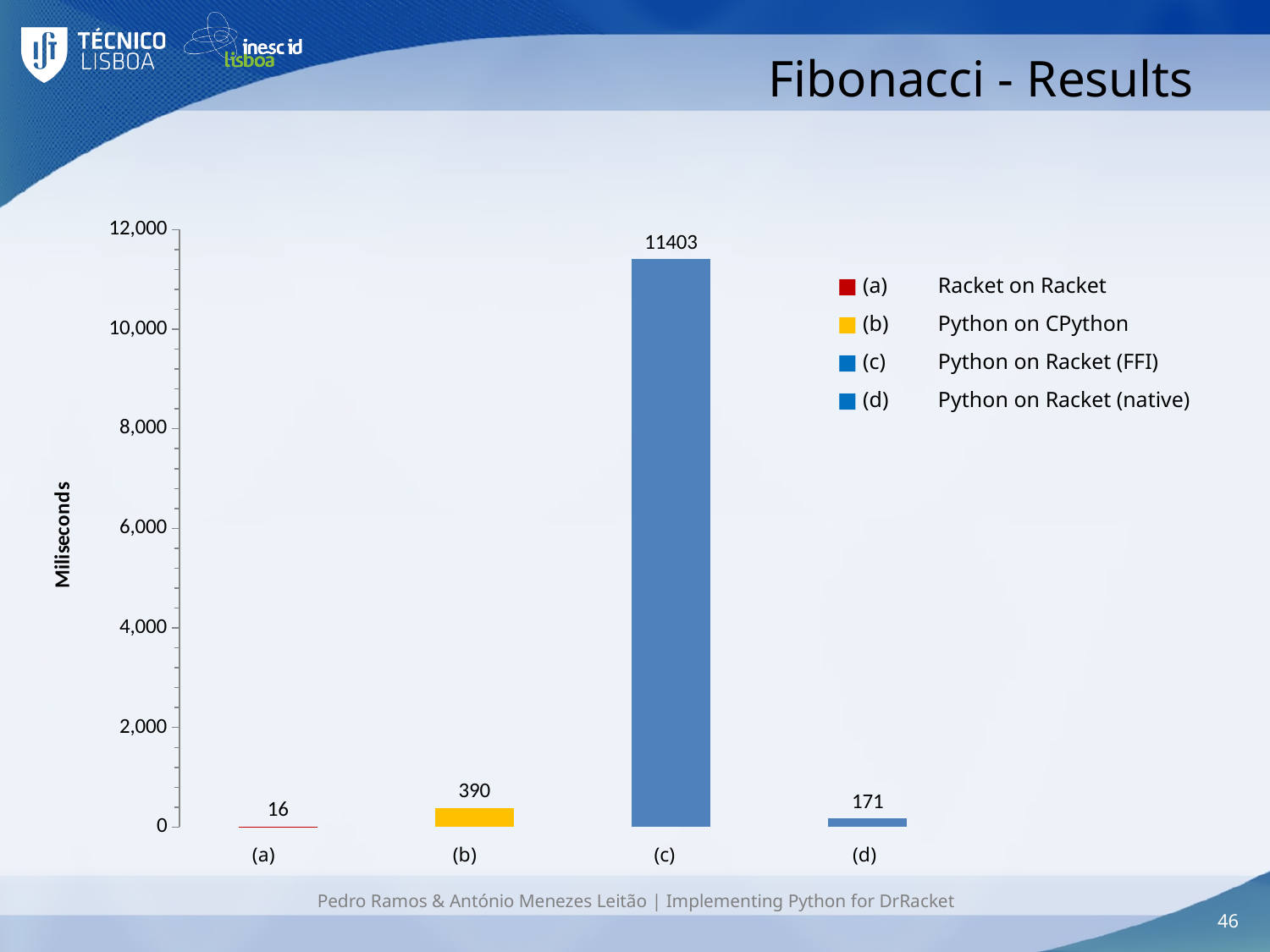
Which is larger, the value for (b) or the value for (d)? (b) What is the difference between the values for (b) and (d)? 219 What is the value for (d) in the Fibonacci results chart? 171 Which category has the highest value in the Fibonacci results chart? (c) What is the value for (a) in the Fibonacci results chart? 16 What is the value for (c) in the Fibonacci results chart? 11403 According to the legend, what does (c) stand for? Python on Racket (FFI) What is the value for (b) in the Fibonacci results chart? 390 Which category has the lowest value in the Fibonacci results chart? (a) What kind of chart is shown on the slide? bar chart Is the value for (c) greater or less than 10,000? greater How many categories are shown on the x axis of the chart? 4